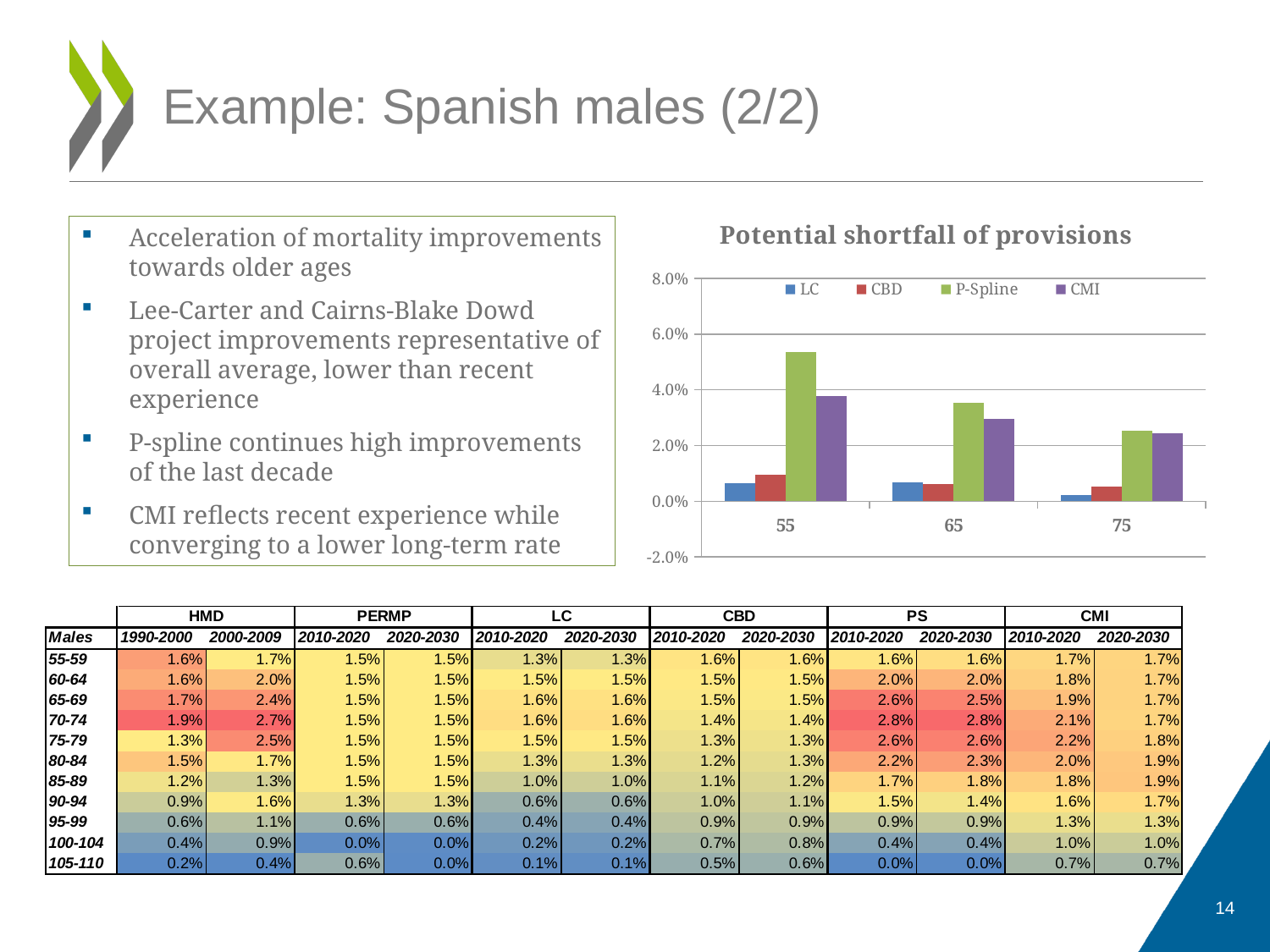
Which series is shown in green in the chart's legend? P-Spline Which series has the lowest bar for age 75? LC Which is larger for age 55, the P-Spline value or the CMI value? P-Spline How many series does the chart's legend list? 4 What kind of chart is shown on the slide? bar chart How many age categories are shown on the x axis of the chart? 3 What is the title of the chart? Potential shortfall of provisions Which series has the highest bar for age 55? P-Spline Do the P-Spline values rise or fall as age increases from 55 to 75? fall Is the LC value for age 55 greater or less than 2.0%? less Is the P-Spline value for age 65 greater or less than 4.0%? less Is the P-Spline value for age 55 greater or less than 4.0%? greater